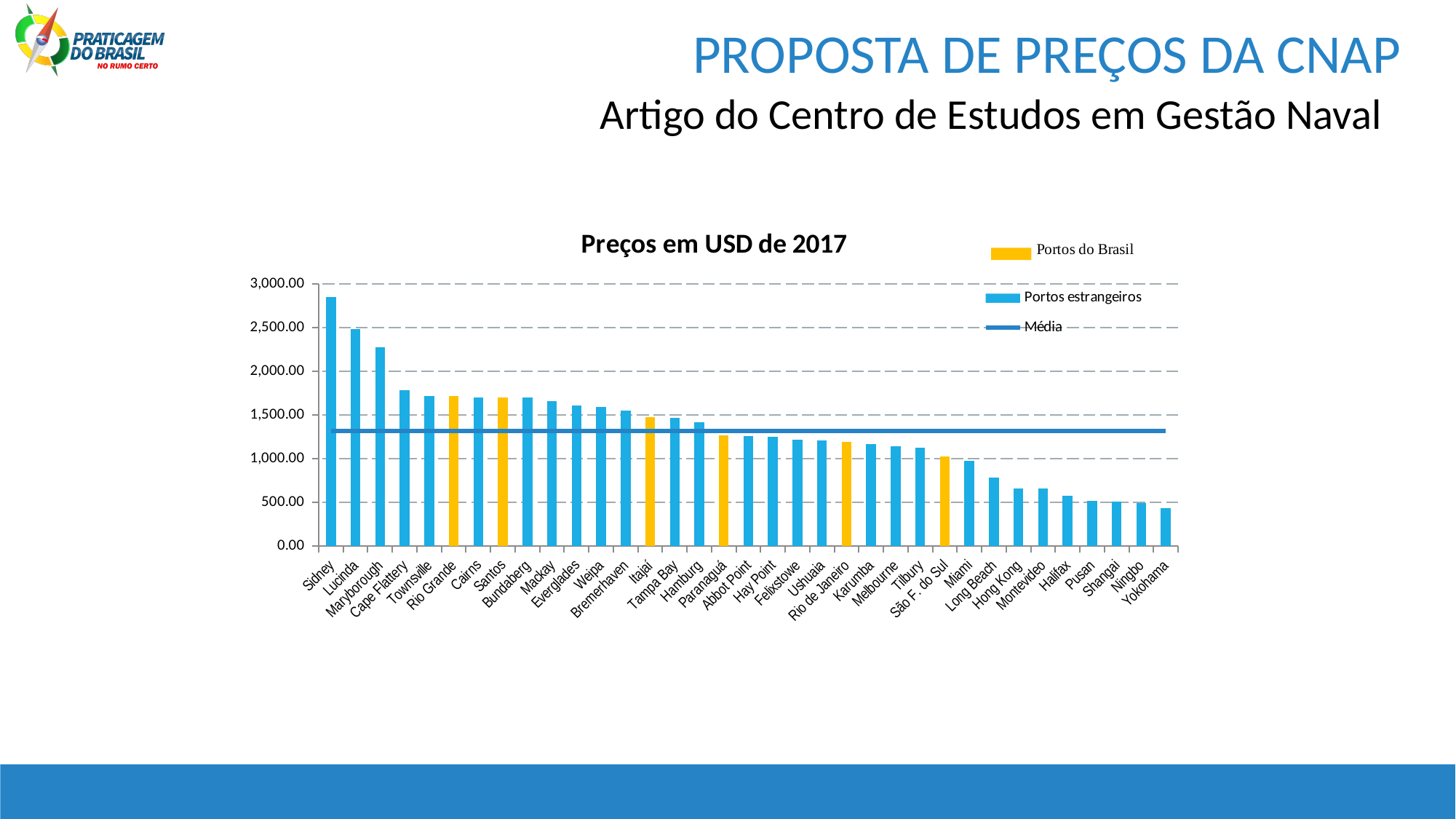
How many ports are shown on the x axis of the chart? 35 What is the title of the chart? Preços em USD de 2017 Which port has the highest price in the chart? Sidney Which port has the lowest price in the chart? Yokohama Is the value for Maryborough greater or less than 2,000.00? greater Do the bar values rise or fall from left to right along the x axis? Fall Which has a higher price, Santos or Paranaguá? Santos Is the value for Sidney greater or less than 2,500.00? greater Is the value for Paranaguá greater or less than 1,500.00? less How many entries does the chart legend list? 3 What kind of chart is shown on the slide? Bar chart with a line (combination bar and line chart)